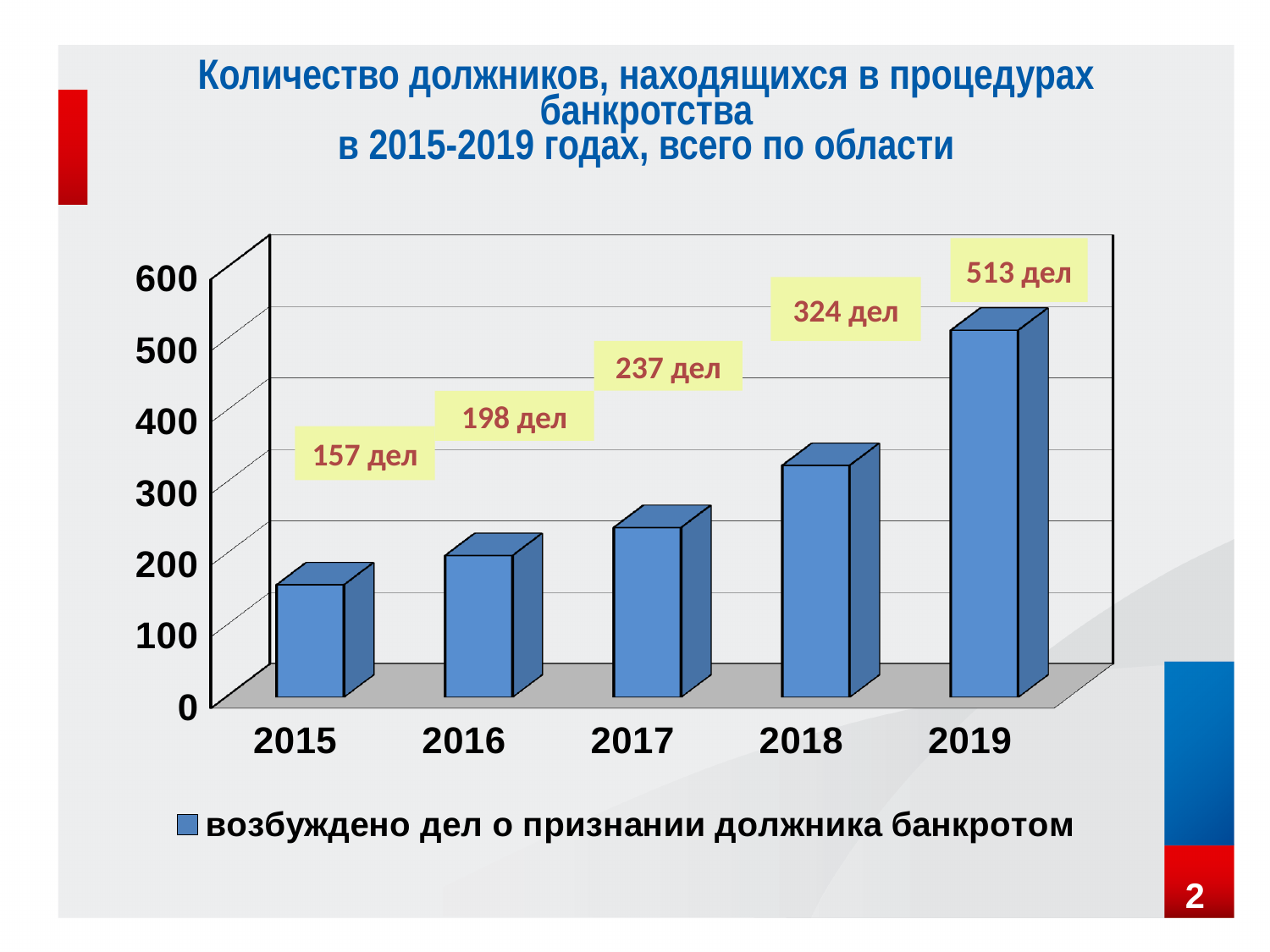
What is the value for 2017? 237 дел What is the difference between the values for 2016 and 2015? 41 дел Is the value for 2018 greater or less than 300? greater Do the values rise or fall from 2015 to 2019? rise What is the difference between the values for 2019 and 2018? 189 дел Which year has the highest value? 2019 How many years are shown on the x axis? 5 What is the value for 2015? 157 дел Which year has the lowest value? 2015 What is the value for 2019? 513 дел Which is larger, the value for 2017 or the value for 2018? 2018 What kind of chart is shown on the slide? bar chart